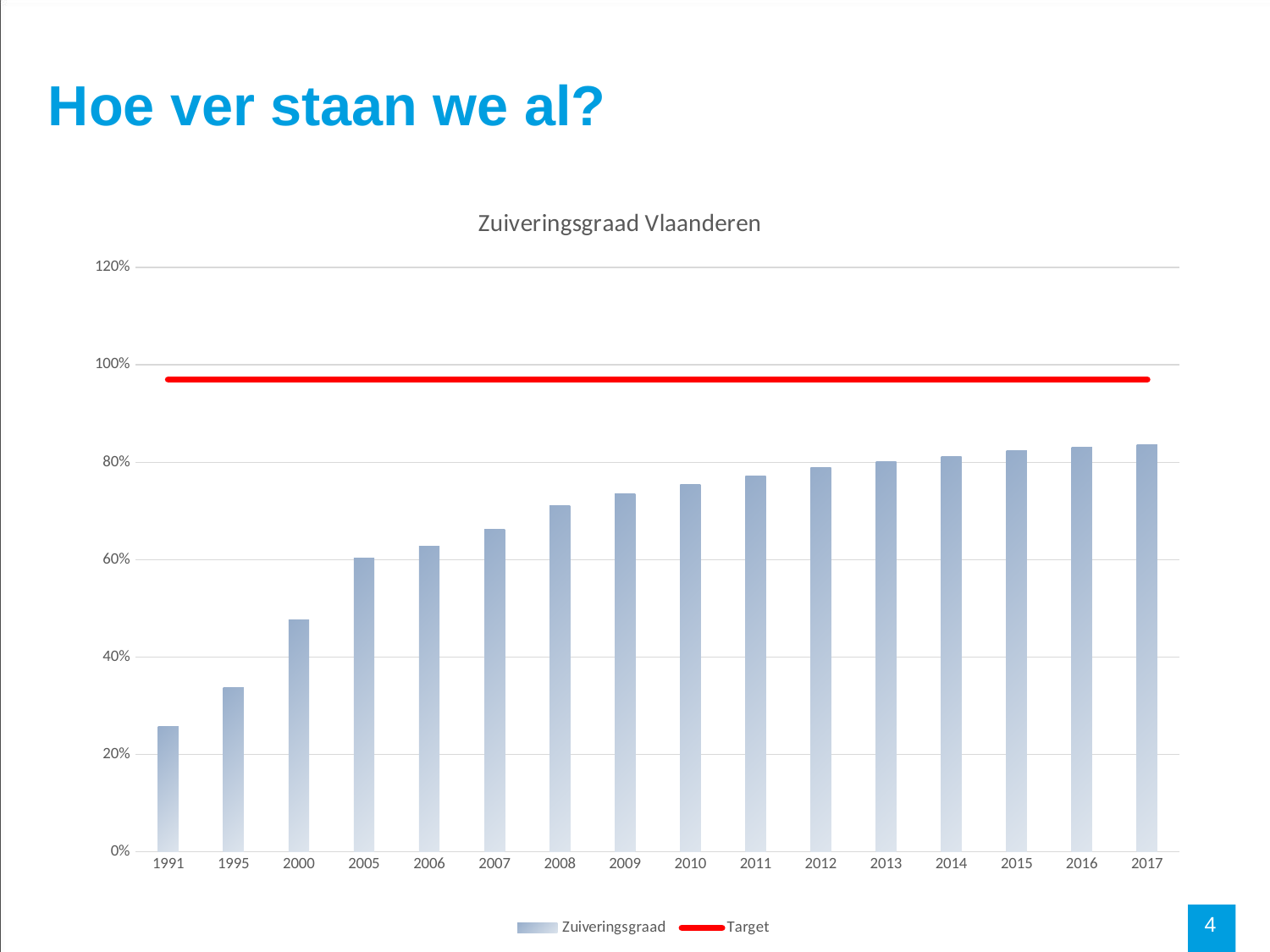
Which year has the highest Zuiveringsgraad? 2017 Is the Target line greater or less than 100%? less What kind of chart is shown on the slide? combination bar and line chart Is the Zuiveringsgraad for 2000 greater or less than 40%? greater Is the Zuiveringsgraad for 1991 greater or less than 40%? less How many years are shown on the x axis? 16 Which year has the lowest Zuiveringsgraad? 1991 Do the Zuiveringsgraad values rise or fall from 1991 to 2017? rise What is the title of the chart? Zuiveringsgraad Vlaanderen How many series does the legend list? 2 Which is larger, the Zuiveringsgraad for 2005 or for 1995? 2005